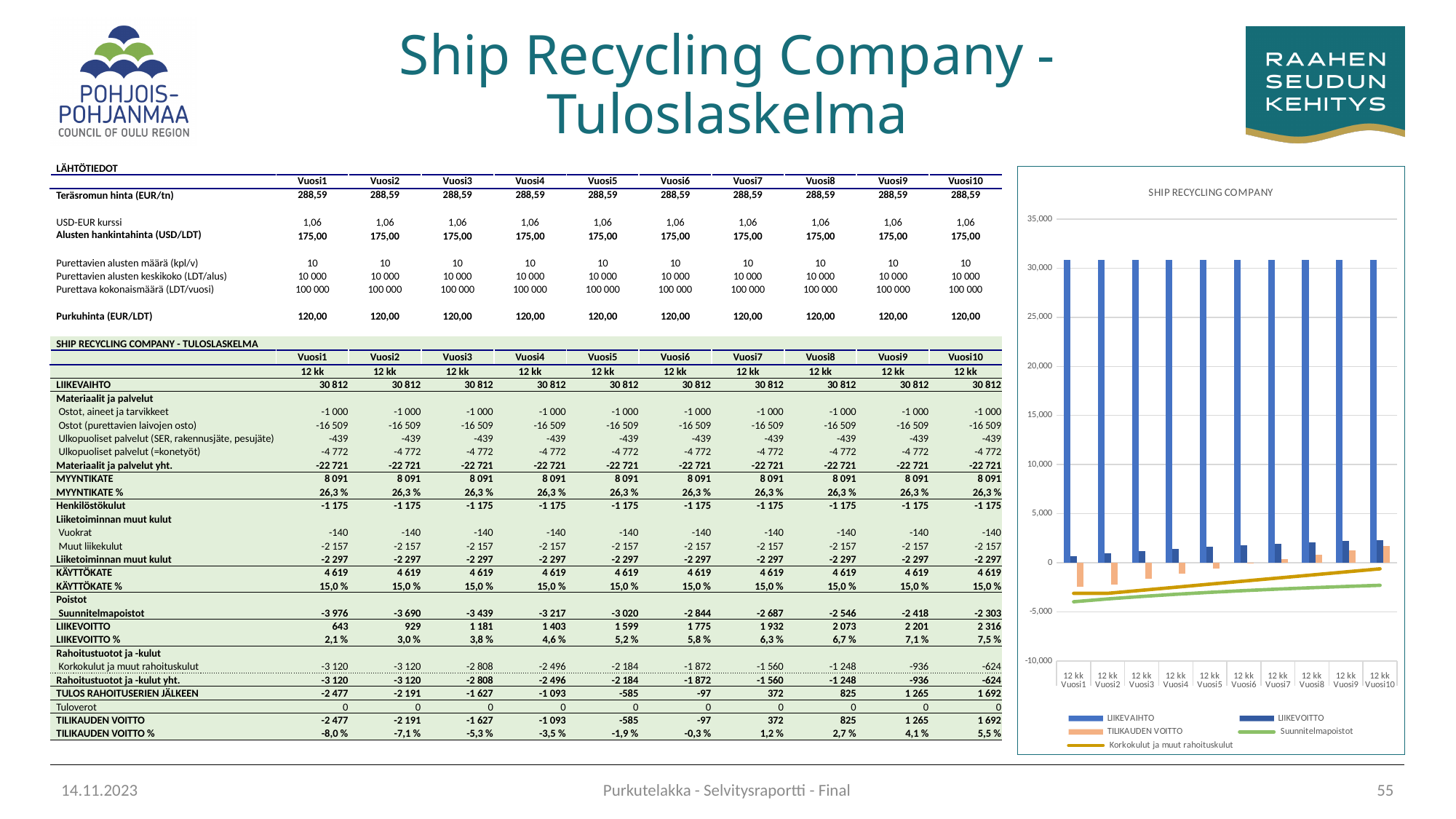
What kind of chart is the SHIP RECYCLING COMPANY chart? Combined bar and line chart In the SHIP RECYCLING COMPANY chart, which is larger for 12 kk Vuosi1: LIIKEVAIHTO or LIIKEVOITTO? LIIKEVAIHTO What is the title of the chart on the right side of the slide? SHIP RECYCLING COMPANY How many year categories are shown on the x axis of the SHIP RECYCLING COMPANY chart? 10 In the SHIP RECYCLING COMPANY chart, is the LIIKEVOITTO bar for 12 kk Vuosi10 greater or less than 5,000? less In the SHIP RECYCLING COMPANY chart, which two series are drawn as lines rather than bars? Suunnitelmapoistot and Korkokulut ja muut rahoituskulut In the SHIP RECYCLING COMPANY chart, do the LIIKEVAIHTO bars rise, fall or stay flat from Vuosi1 to Vuosi10? stay flat In the SHIP RECYCLING COMPANY chart, is the LIIKEVAIHTO bar for 12 kk Vuosi1 greater or less than 25,000? greater How many series does the legend of the SHIP RECYCLING COMPANY chart list? 5 In the SHIP RECYCLING COMPANY chart, is the Korkokulut ja muut rahoituskulut line at 12 kk Vuosi1 greater or less than 0? less In the SHIP RECYCLING COMPANY chart, do the LIIKEVOITTO bars rise or fall from Vuosi1 to Vuosi10? rise